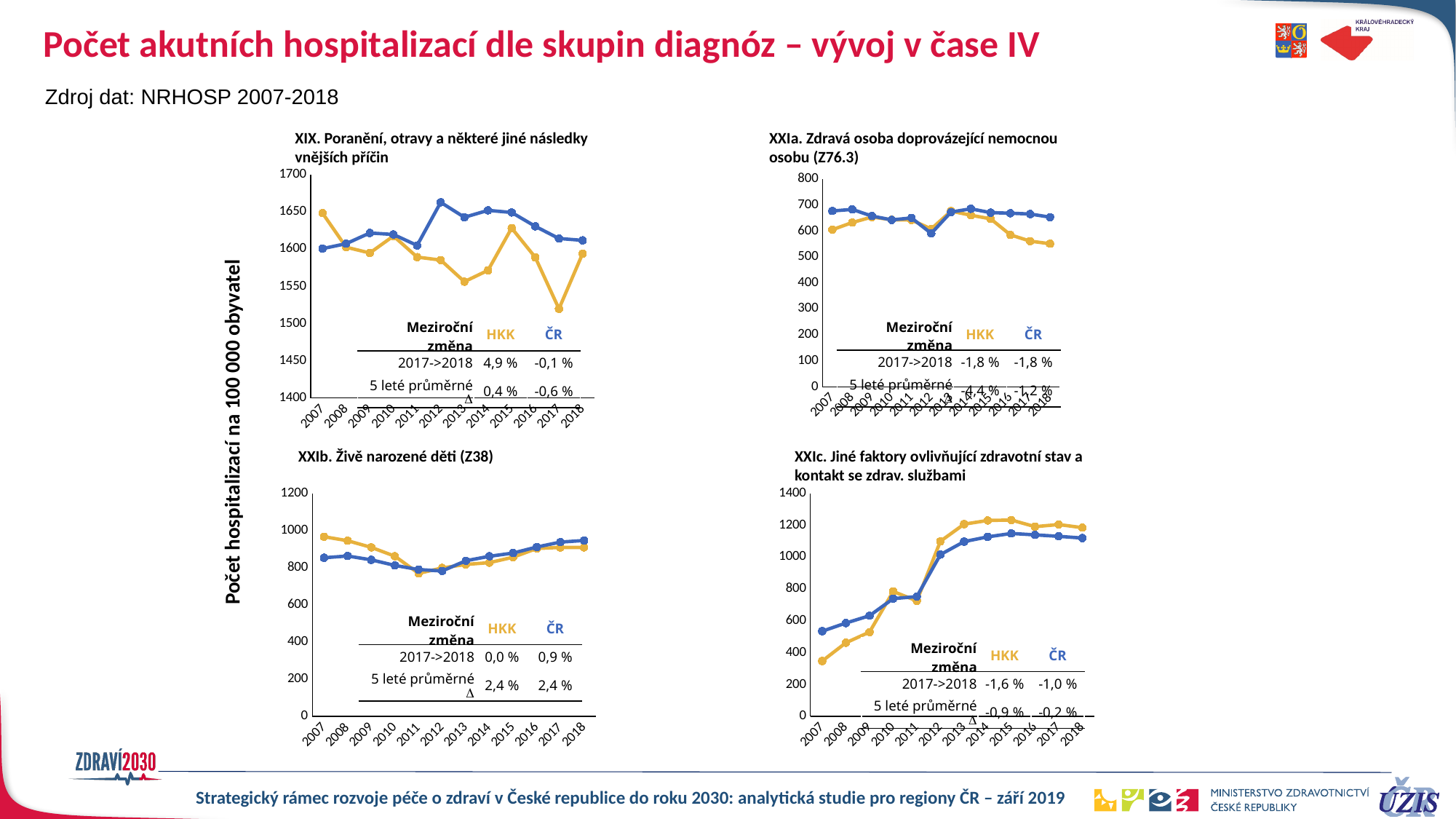
In the chart 'XIX. Poranění, otravy a některé jiné následky vnějších příčin', what is the 5 leté průměrné Δ for ČR? -0,6 % In the chart 'XIX. Poranění, otravy a některé jiné následky vnějších příčin', is the HKK value for 2017 greater or less than 1550? less In the chart 'XIX. Poranění, otravy a některé jiné následky vnějších příčin', which series has the higher value in 2017, HKK or ČR? ČR In the chart 'XXIa. Zdravá osoba doprovázející nemocnou osobu (Z76.3)', what is the 5 leté průměrné Δ for HKK? -4,4 % In the chart 'XIX. Poranění, otravy a některé jiné následky vnějších příčin', what is the 2017->2018 change for HKK? 4,9 % In the chart 'XXIc. Jiné faktory ovlivňující zdravotní stav a kontakt se zdrav. službami', do the values generally rise or fall from 2007 to 2018? rise In the chart 'XXIa. Zdravá osoba doprovázející nemocnou osobu (Z76.3)', is the HKK value for 2018 greater or less than 600? less In the chart 'XXIc. Jiné faktory ovlivňující zdravotní stav a kontakt se zdrav. službami', is the HKK value for 2007 greater or less than 400? less In the chart 'XXIb. Živě narozené děti (Z38)', what is the 2017->2018 change for ČR? 0,9 % In the chart 'XXIc. Jiné faktory ovlivňující zdravotní stav a kontakt se zdrav. službami', what is the 2017->2018 change for HKK? -1,6 % What kind of chart is 'XXIa. Zdravá osoba doprovázející nemocnou osobu (Z76.3)'? line chart How many years are plotted on the x axis of the chart 'XXIb. Živě narozené děti (Z38)'? 12